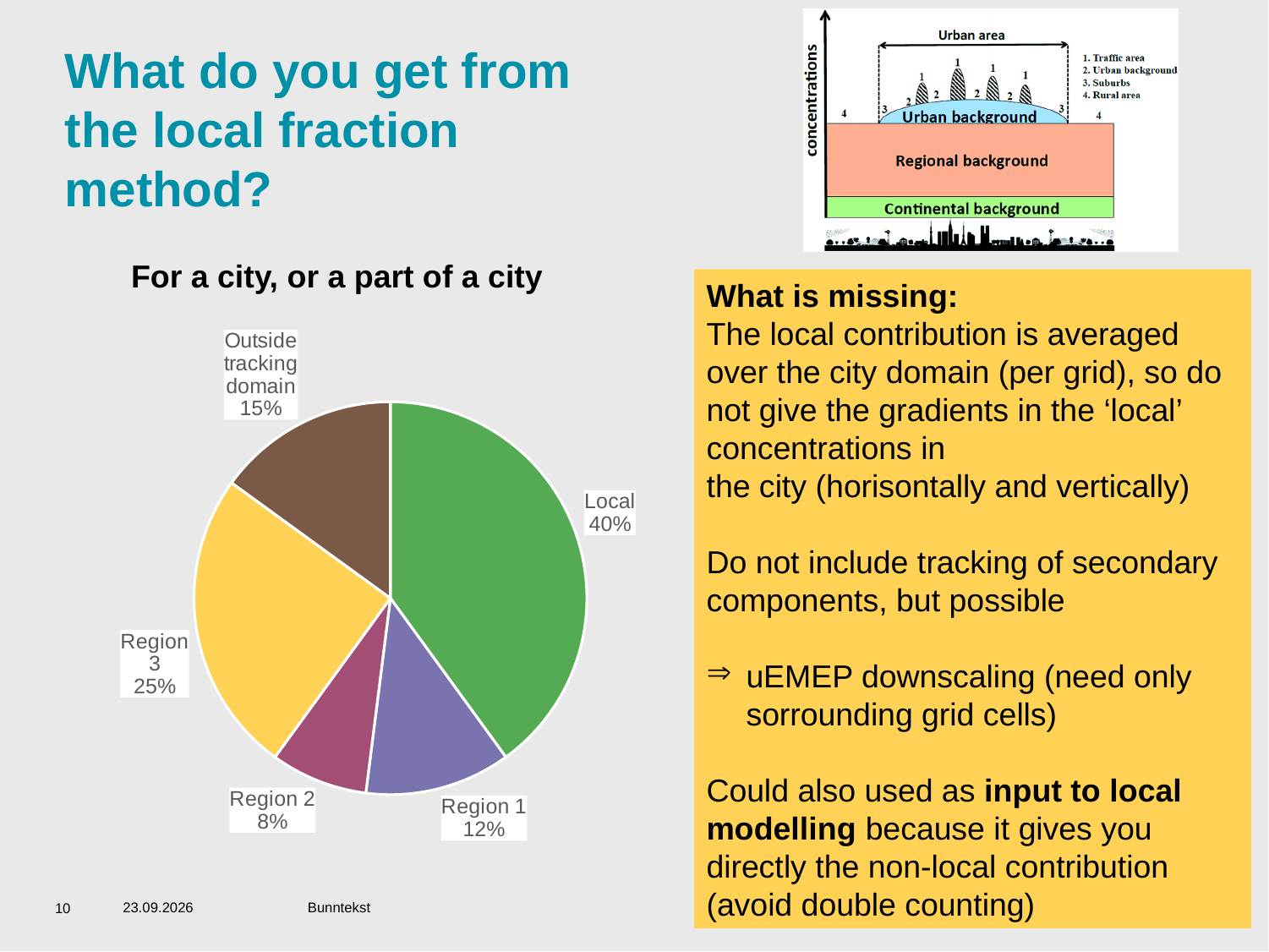
What kind of chart is shown on the slide? Pie chart Which slice of the pie chart is the largest? Local What is the title of the pie chart? For a city, or a part of a city Which is larger in the pie chart, Region 1 or Outside tracking domain? Outside tracking domain What percentage is shown for Outside tracking domain in the pie chart? 15% Which slice of the pie chart is the smallest? Region 2 What share of the pie chart does Local account for? 40% What is the difference in percentage points between Local and Region 3 in the pie chart? 15 What colour is the Region 3 slice in the pie chart? Yellow How many slices does the pie chart have? 5 What percentage is shown for Region 2 in the pie chart? 8% What percentage is shown for Region 3 in the pie chart? 25%